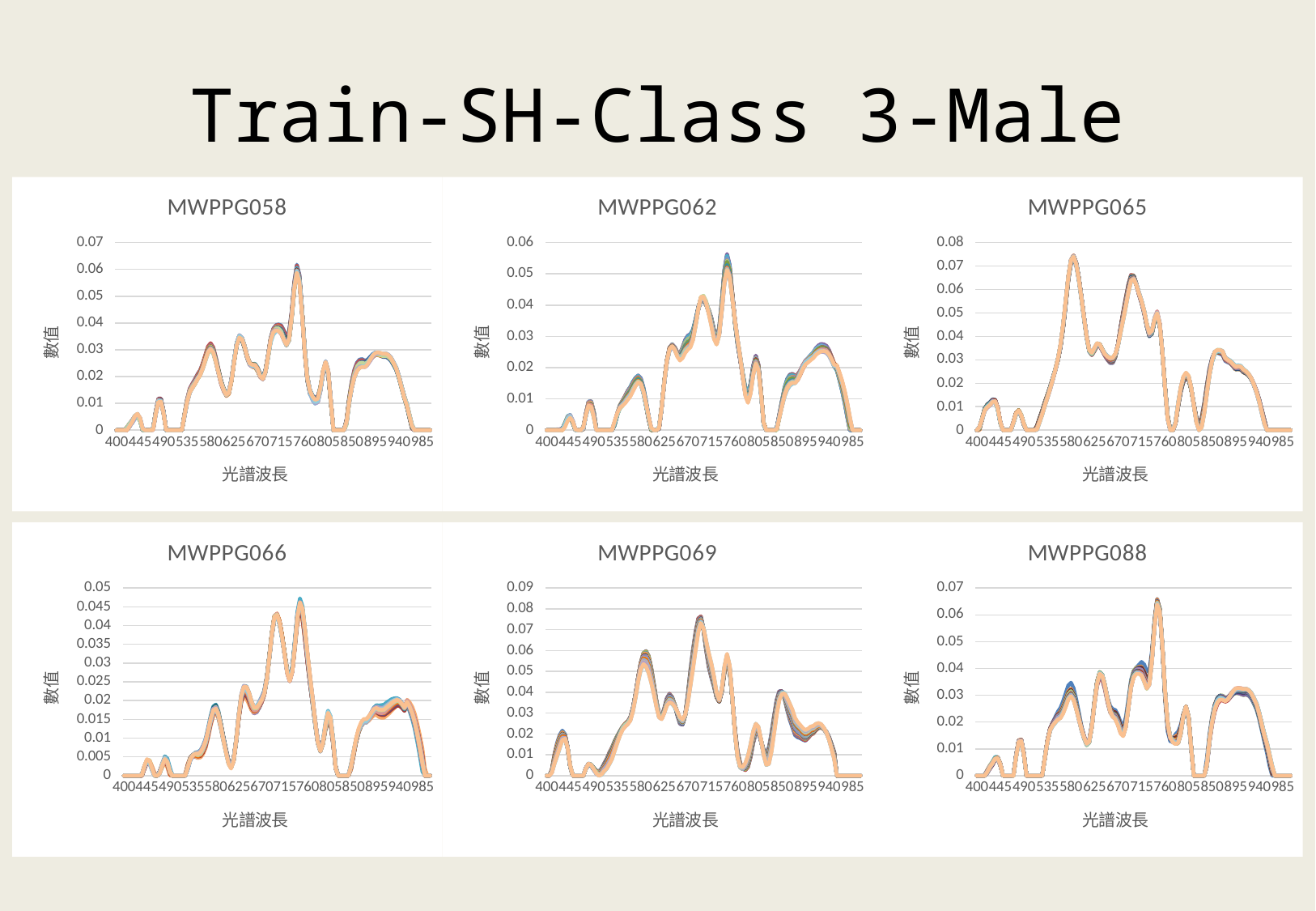
In the MWPPG065 chart, is the highest peak greater or less than 0.06? greater In the MWPPG066 chart, is the highest peak greater or less than 0.04? greater In the MWPPG069 chart, is the highest peak greater or less than 0.06? greater What kind of chart is MWPPG058? line chart What is the highest tick value on the y axis of the MWPPG069 chart? 0.09 In the MWPPG065 chart, which peak is higher: the one near 580 or the one near 715? the one near 580 In the MWPPG058 chart, do the values rise or fall between 940 and 985 on the x axis? fall How many charts are shown on the slide? 6 What is the x-axis title of the MWPPG062 chart? 光譜波長